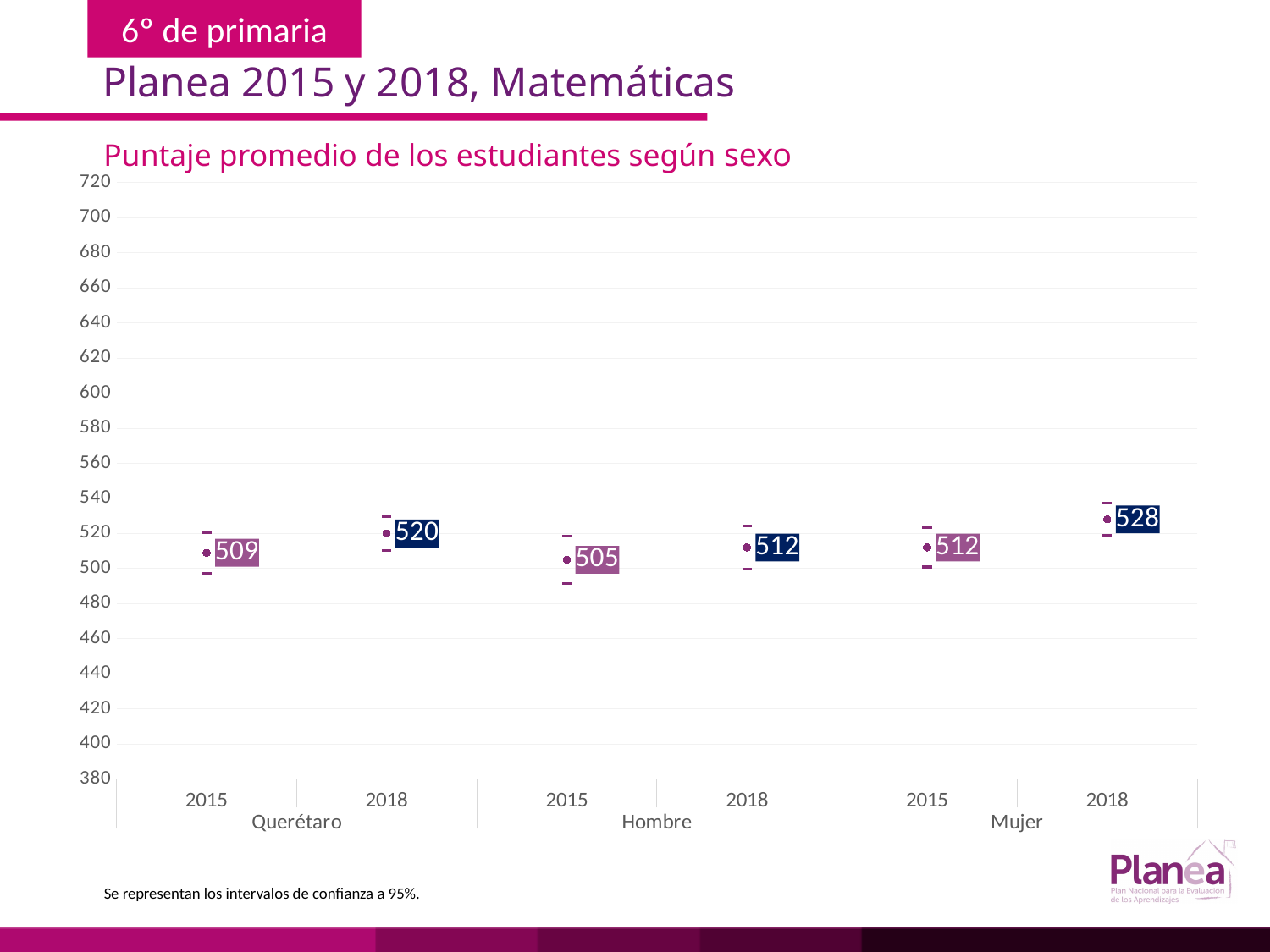
What is the average score for Querétaro in 2018? 520 What is the difference between the Mujer scores in 2018 and 2015? 16 What is the average score for Querétaro in 2015? 509 Which group and year has the highest average score? Mujer 2018 What is the average score for Hombre in 2015? 505 By how many points did the Querétaro average score change from 2015 to 2018? 11 Is the value for Hombre in 2015 greater or less than 600? less Which is larger in 2018, the Hombre score or the Mujer score? Mujer Did the Hombre average score rise or fall from 2015 to 2018? rise Which group and year has the lowest average score? Hombre 2015 What is the average score for Mujer in 2018? 528